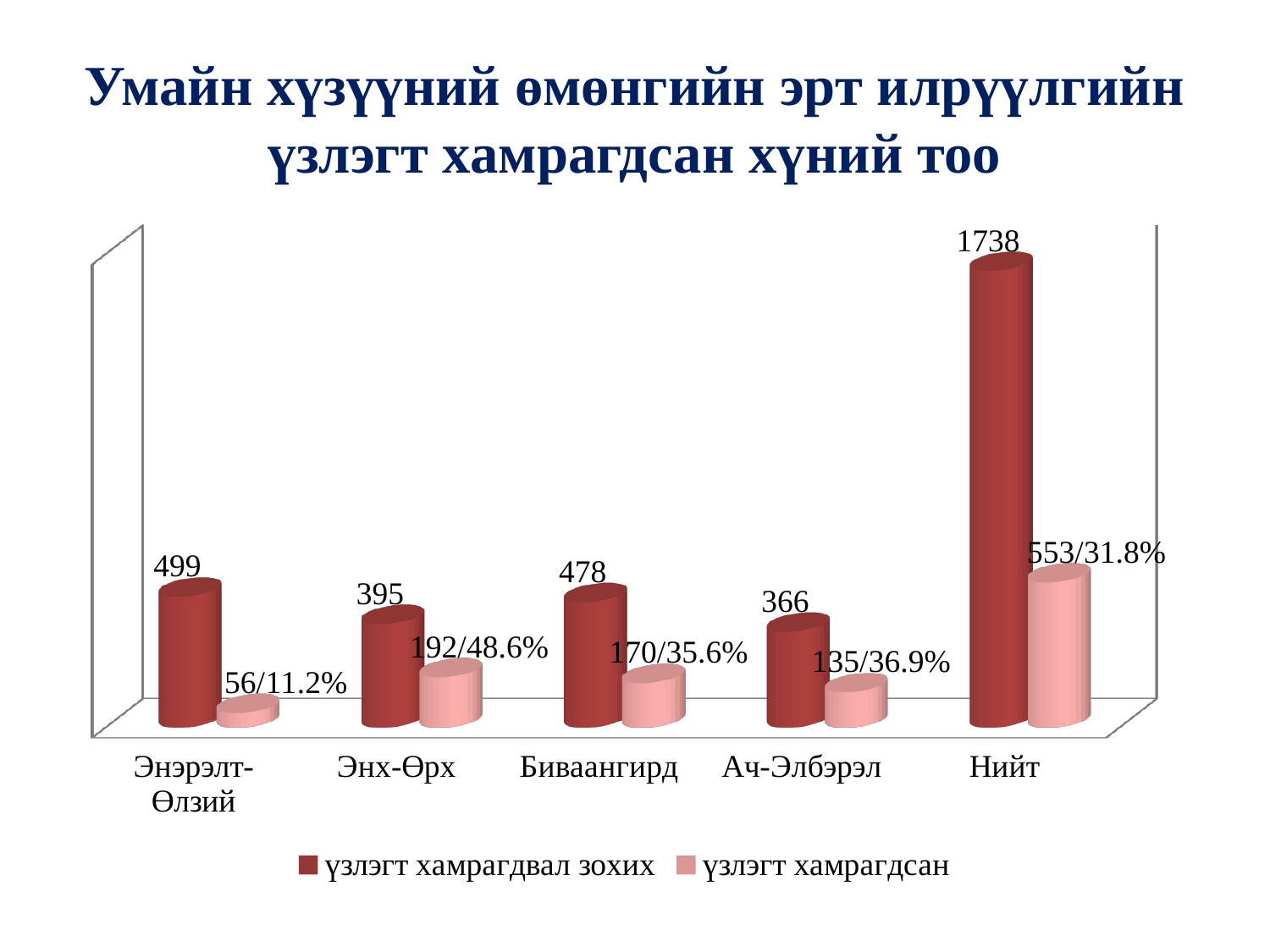
What is the title of the chart on the slide? Умайн хүзүүний өмөнгийн эрт илрүүлгийн үзлэгт хамрагдсан хүний тоо What is the value of 'үзлэгт хамрагдвал зохих' for Нийт? 1738 Excluding Нийт, which category has the lowest value for 'үзлэгт хамрагдсан'? Энэрэлт-Өлзий How many categories are shown on the x axis? 5 What is the difference between 'үзлэгт хамрагдвал зохих' for Биваангирд and Ач-Элбэрэл? 112 What is the data label for 'үзлэгт хамрагдсан' for Энх-Өрх? 192/48.6% Excluding Нийт, which category has the highest value for 'үзлэгт хамрагдвал зохих'? Энэрэлт-Өлзий What is the value of 'үзлэгт хамрагдвал зохих' for Энэрэлт-Өлзий? 499 What is the data label for 'үзлэгт хамрагдсан' for Ач-Элбэрэл? 135/36.9% Which is larger: 'үзлэгт хамрагдсан' for Энх-Өрх or for Биваангирд? Энх-Өрх How many series does the legend list? 2 What type of chart is shown on the slide? Bar chart